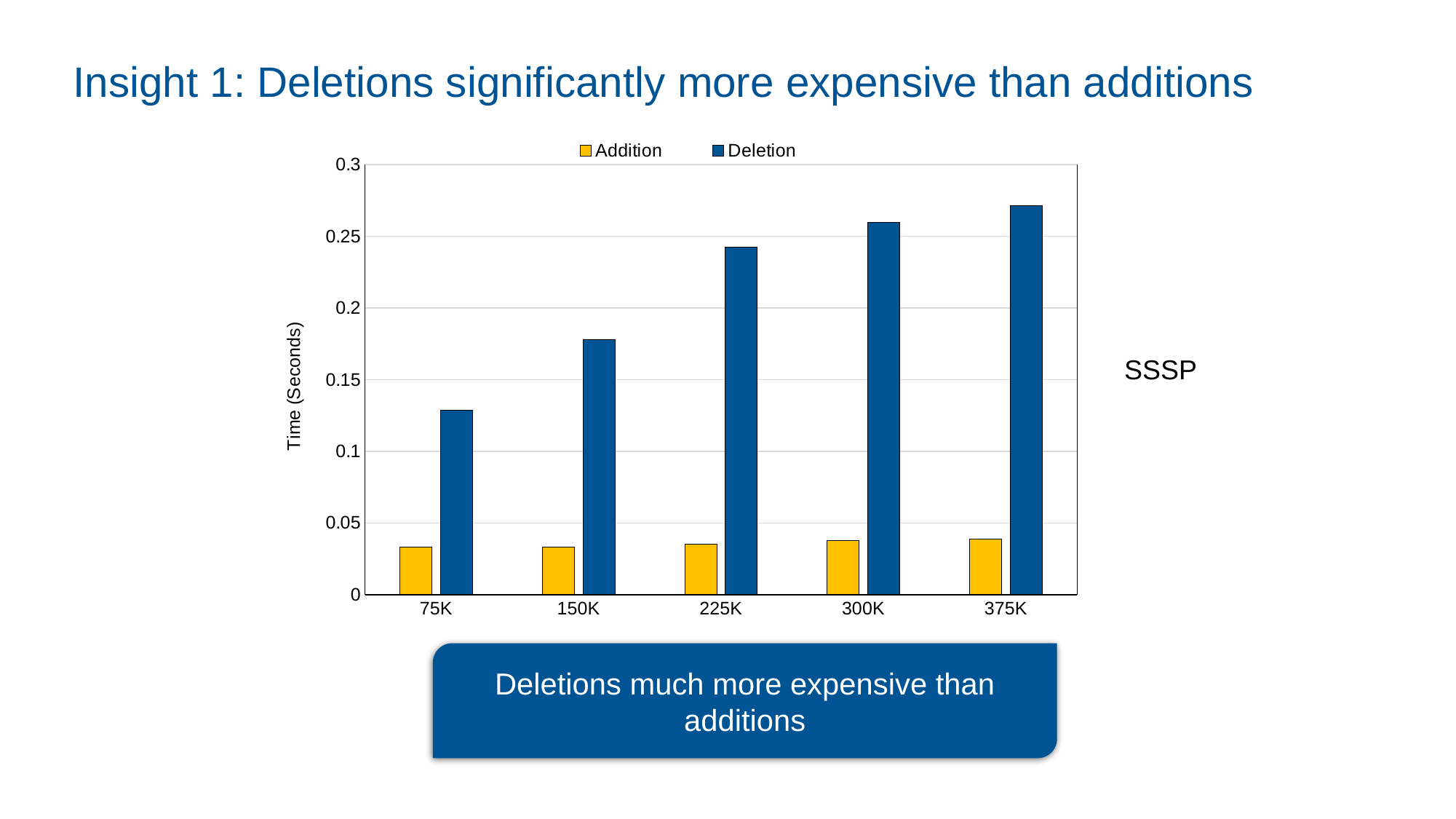
Do the Deletion values rise or fall as the x axis goes from 75K to 375K? rise Is the Addition value for 75K greater or less than 0.05? less How many series does the legend list? 2 Which category has the lowest Deletion value? 75K What is the label of the y axis? Time (Seconds) How many categories are shown on the x axis? 5 Which category has the highest Deletion value? 375K Is the Deletion value for 300K greater or less than 0.25? greater Is the Deletion value for 150K greater or less than 0.2? less What kind of chart is shown on the slide? bar chart Which is larger at 75K, the Addition value or the Deletion value? Deletion